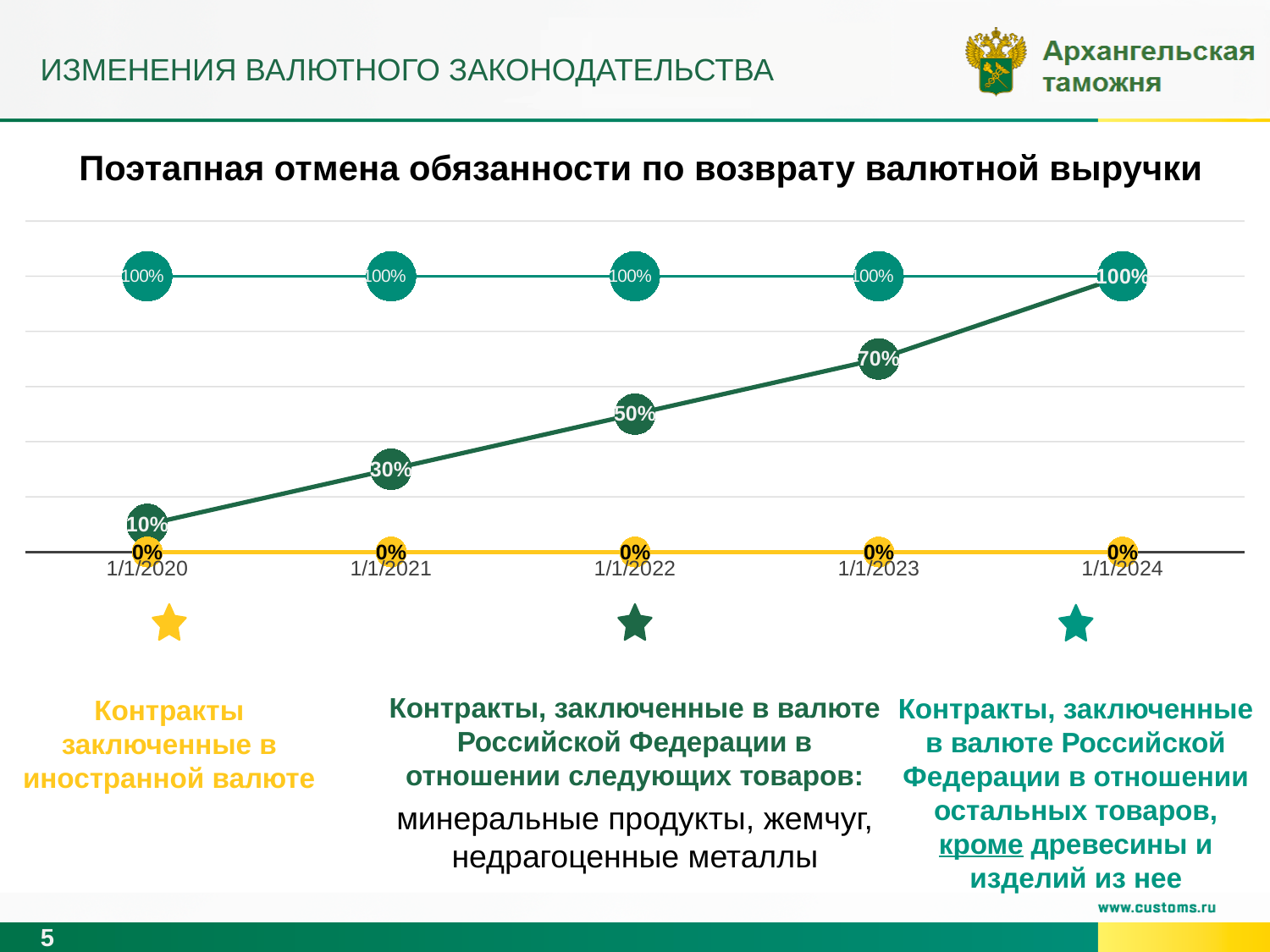
At which date does the rising dark green line reach its lowest value? 1/1/2020 What is the value of the rising dark green line at 1/1/2023? 70% How many dates are plotted along the x axis? 5 What value does the teal line hold at every date? 100% What kind of chart is shown on the slide? line chart Does the dark green line rise or fall from 1/1/2020 to 1/1/2024? rise What is the value of the rising dark green line at 1/1/2022? 50% What is the value of the rising dark green line at 1/1/2020? 10% What is the value of the yellow line at 1/1/2024? 0% At 1/1/2022, which is larger: the teal line or the dark green line? the teal line What is the difference between the dark green line's values at 1/1/2023 and 1/1/2021? 40% What is the value of the rising dark green line at 1/1/2021? 30%